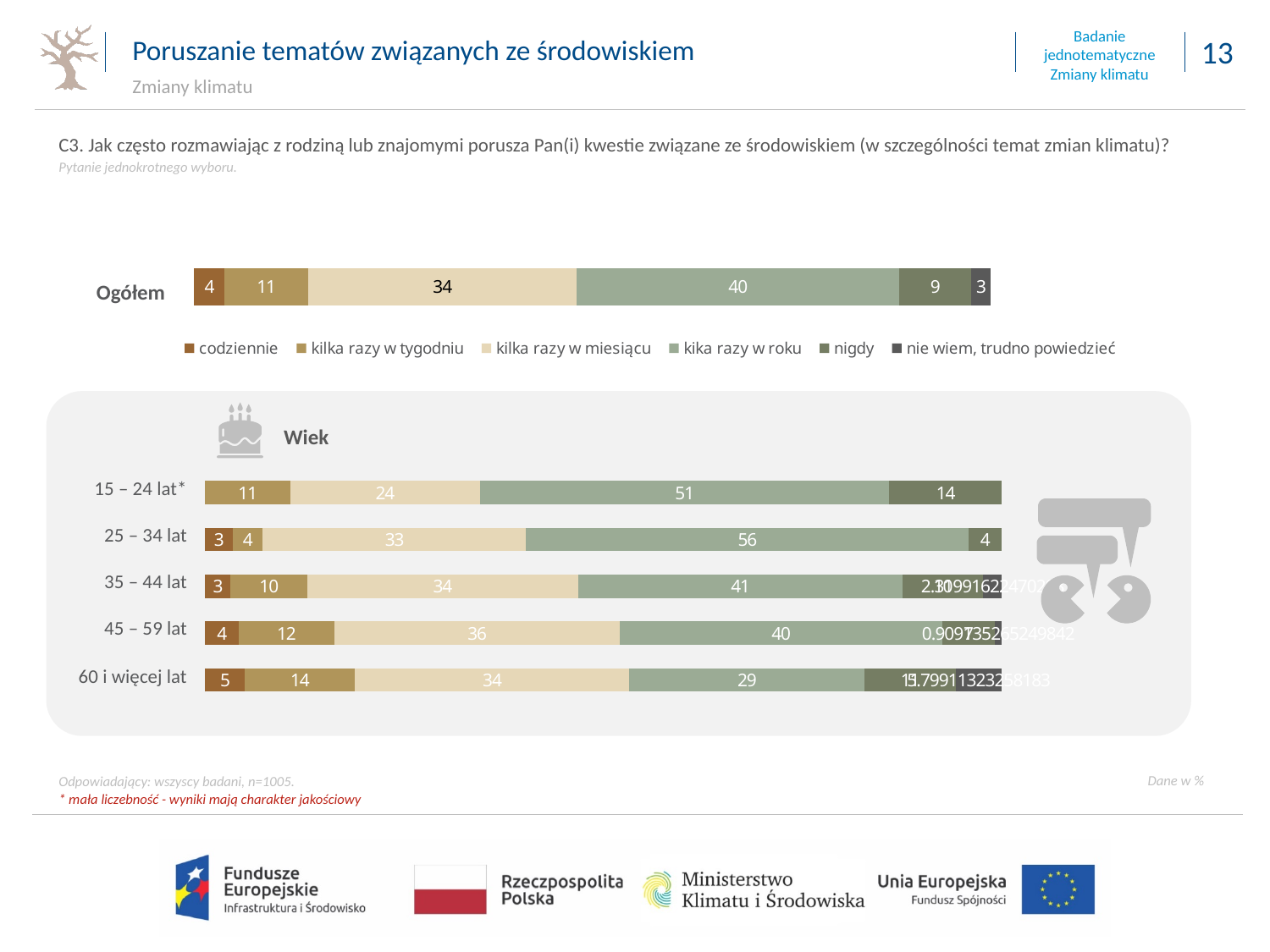
In the Wiek chart, which age group has the highest value for 'kika razy w roku'? 25 – 34 lat In the Wiek chart, what is the value for 'kilka razy w miesiącu' in the 45 – 59 lat group? 36 How many series does the legend of the Ogółem chart list? 6 In the Ogółem chart, what is the difference between 'kika razy w roku' and 'kilka razy w miesiącu'? 6 In the Wiek chart, what is the value for 'nigdy' in the 15 – 24 lat group? 14 In the Wiek chart, what is the value for 'kika razy w roku' in the 25 – 34 lat group? 56 How many age groups are shown in the Wiek chart? 5 In the Ogółem chart, what is the value for 'kilka razy w miesiącu'? 34 In the Ogółem chart, which category has the highest value? kika razy w roku In the Ogółem chart, what is the value for 'kika razy w roku'? 40 In the Wiek chart, which is larger for the 60 i więcej lat group: 'kilka razy w miesiącu' or 'kika razy w roku'? kilka razy w miesiącu What kind of chart is the Ogółem chart? stacked bar chart